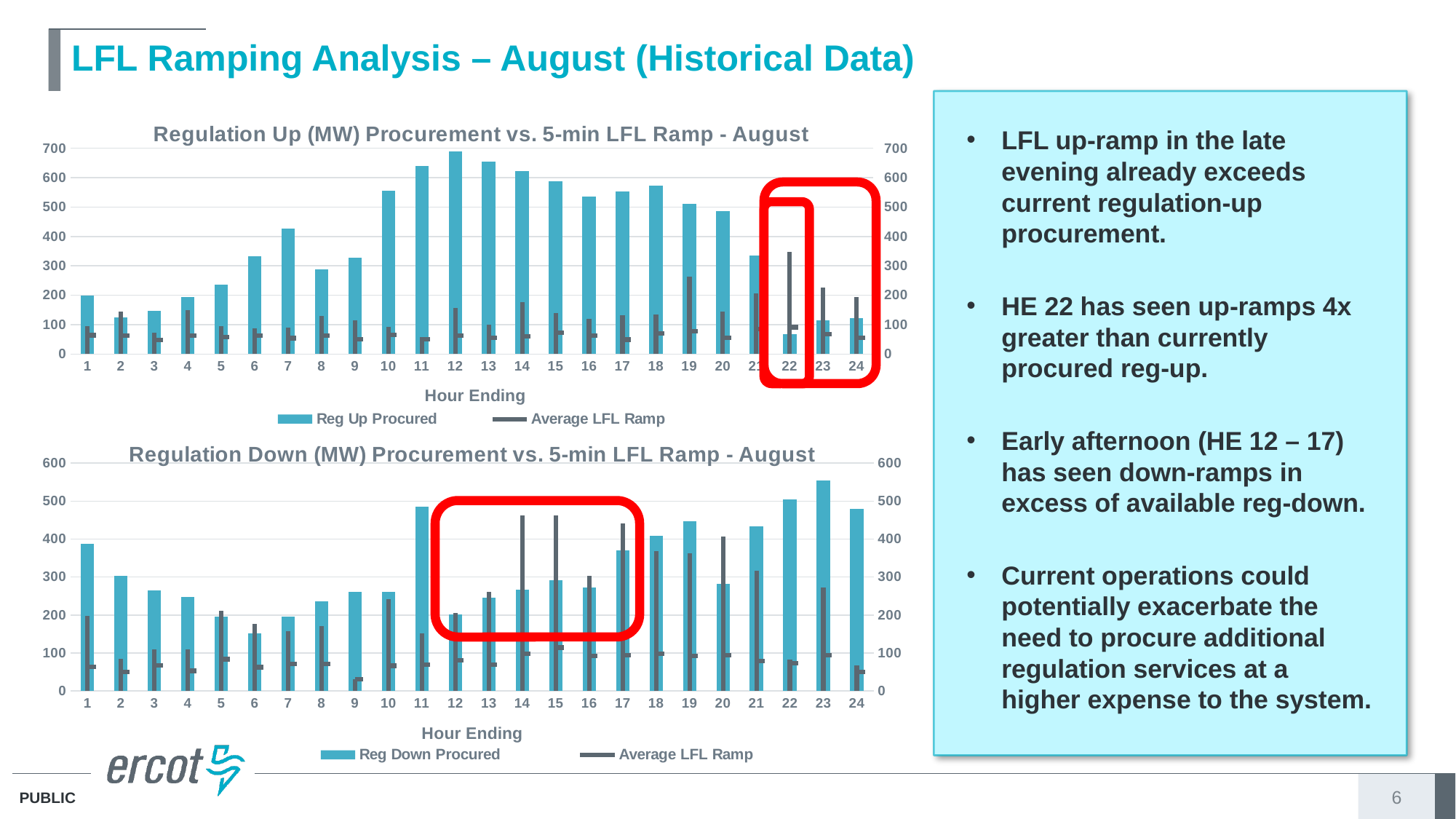
In the top chart (Regulation Up), is the Reg Up Procured value for hour ending 22 greater or less than 100? less In the top chart (Regulation Up), is the Reg Up Procured value for hour ending 12 greater or less than 600? greater In the bottom chart (Regulation Down), which is larger, the Reg Down Procured bar for hour ending 1 or for hour ending 6? hour ending 1 How many series does the legend of the top chart (Regulation Up) list? 2 In the bottom chart (Regulation Down), is the Reg Down Procured value for hour ending 6 greater or less than 200? less What kind of chart is the top chart, 'Regulation Up (MW) Procurement vs. 5-min LFL Ramp - August'? bar chart In the bottom chart (Regulation Down), which hour ending has the lowest Reg Down Procured bar? 6 In the top chart (Regulation Up), which hour ending has the highest Reg Up Procured bar? 12 In the bottom chart (Regulation Down), which hour ending has the highest Reg Down Procured bar? 23 In the top chart (Regulation Up), do the Reg Up Procured bars generally rise or fall from hour ending 1 to hour ending 12? rise In the top chart (Regulation Up), which hour ending has the lowest Reg Up Procured bar? 22 In the top chart (Regulation Up), how many hour-ending categories are shown on the x axis? 24